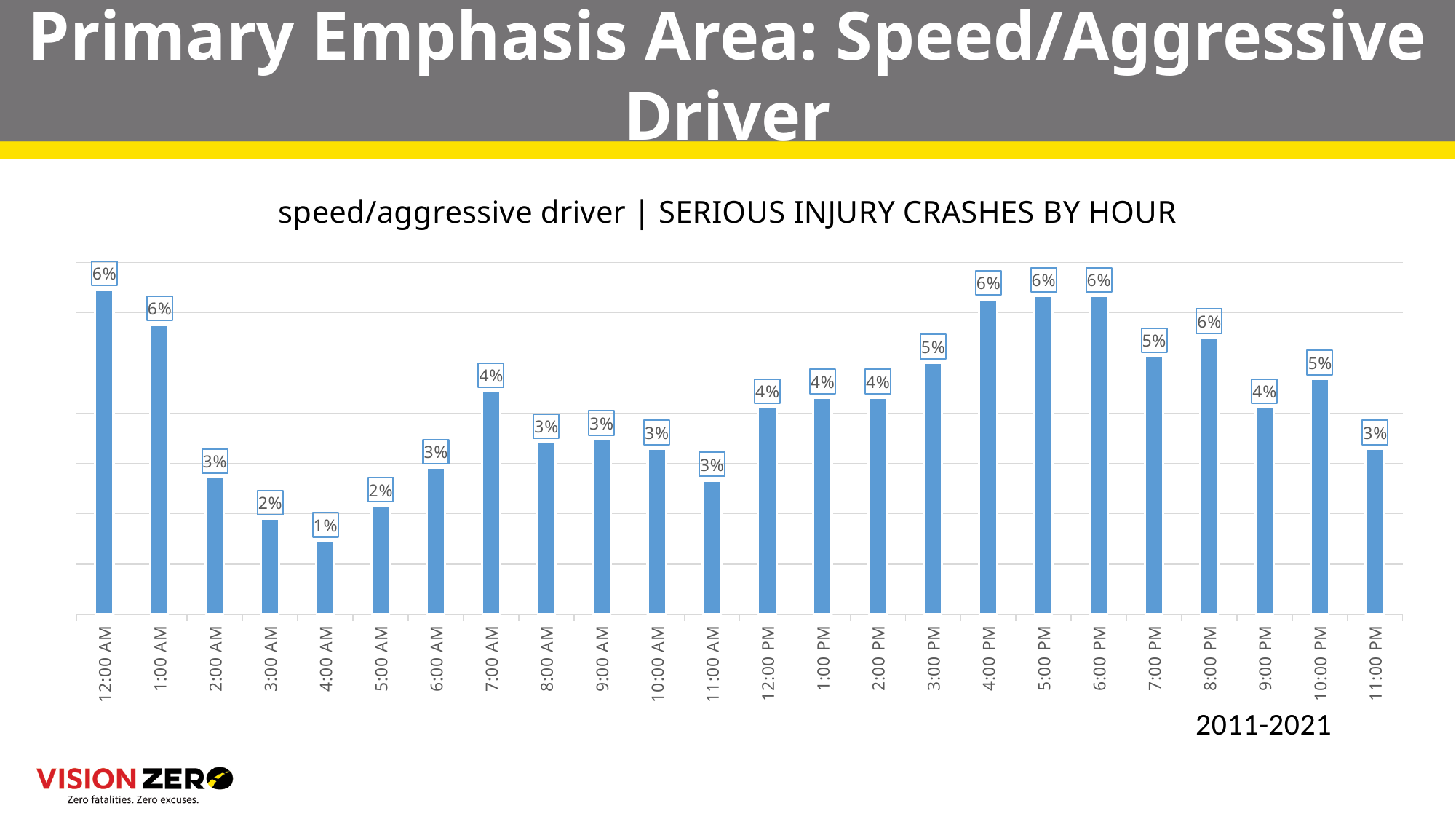
What percentage is shown for 3:00 PM? 5% Do the values rise or fall from 12:00 AM to 4:00 AM? Fall How many hourly categories are plotted on the chart? 24 What is the difference between the value for 12:00 AM and the value for 4:00 AM? 5 percentage points Which hour has the lowest share of serious injury crashes? 4:00 AM What kind of chart is shown on the slide? Bar chart What is the value for 11:00 PM? 3% Which has a higher value, 3:00 AM or 6:00 AM? 6:00 AM What is the value shown for 7:00 AM? 4% What percentage of serious injury crashes occurred at 4:00 AM? 1% Which has a higher value, 7:00 AM or 8:00 AM? 7:00 AM What time period does the chart cover, according to the label below it? 2011-2021